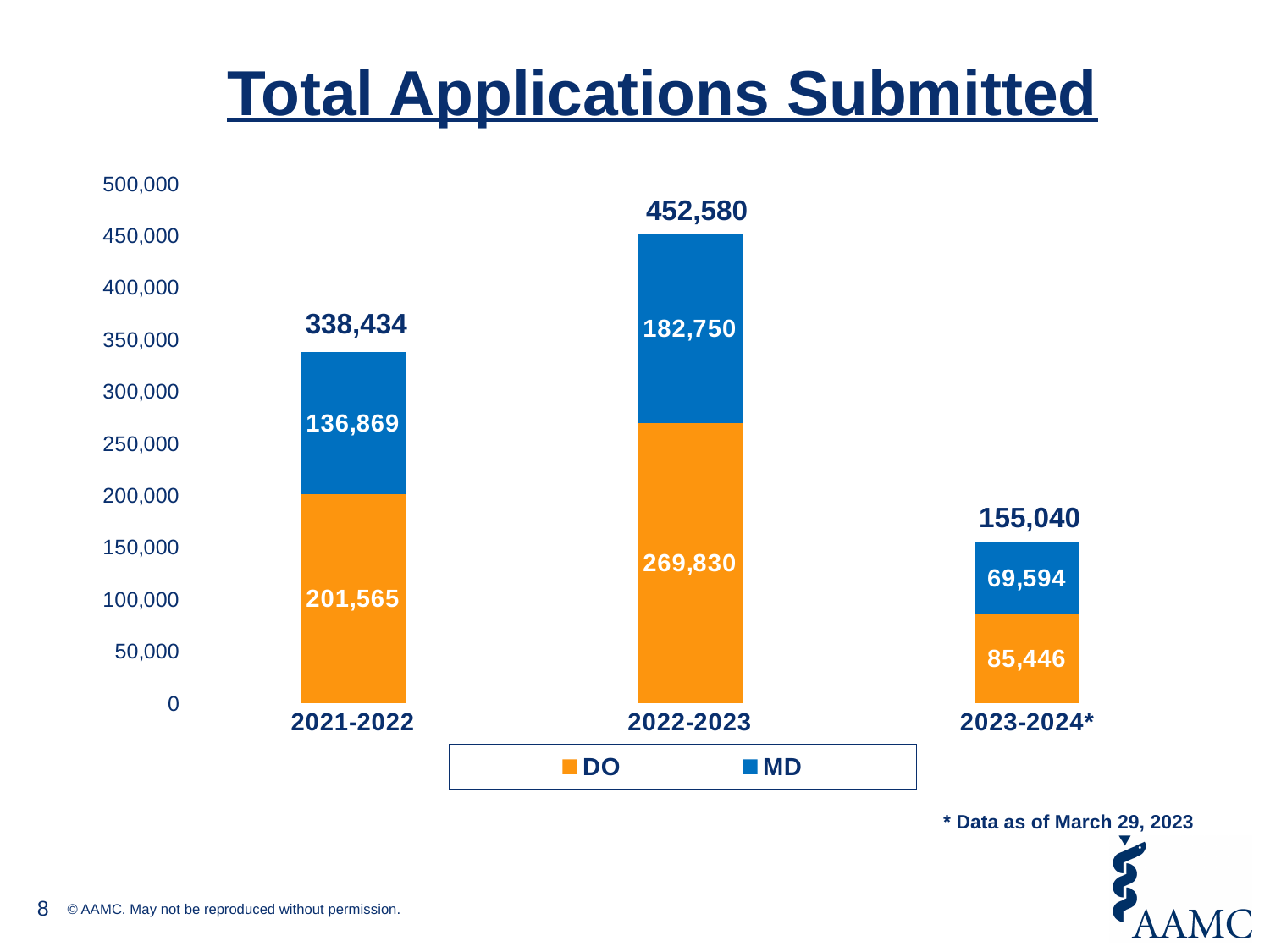
What is the MD value for 2021-2022? 136,869 What is the total of the stacked bar for 2022-2023? 452,580 What is the total of the stacked bar for 2023-2024*? 155,040 Which year has the lowest total applications submitted? 2023-2024* What is the difference between the DO value and the MD value for 2021-2022? 64,696 Which is larger for 2023-2024*, the DO value or the MD value? DO What is the difference between the total for 2022-2023 and the total for 2021-2022? 114,146 How many year categories are shown on the x axis? 3 Which year has the highest total applications submitted? 2022-2023 What kind of chart is shown on the slide? Stacked bar chart How many series does the legend list? 2 What is the DO value for 2022-2023? 269,830